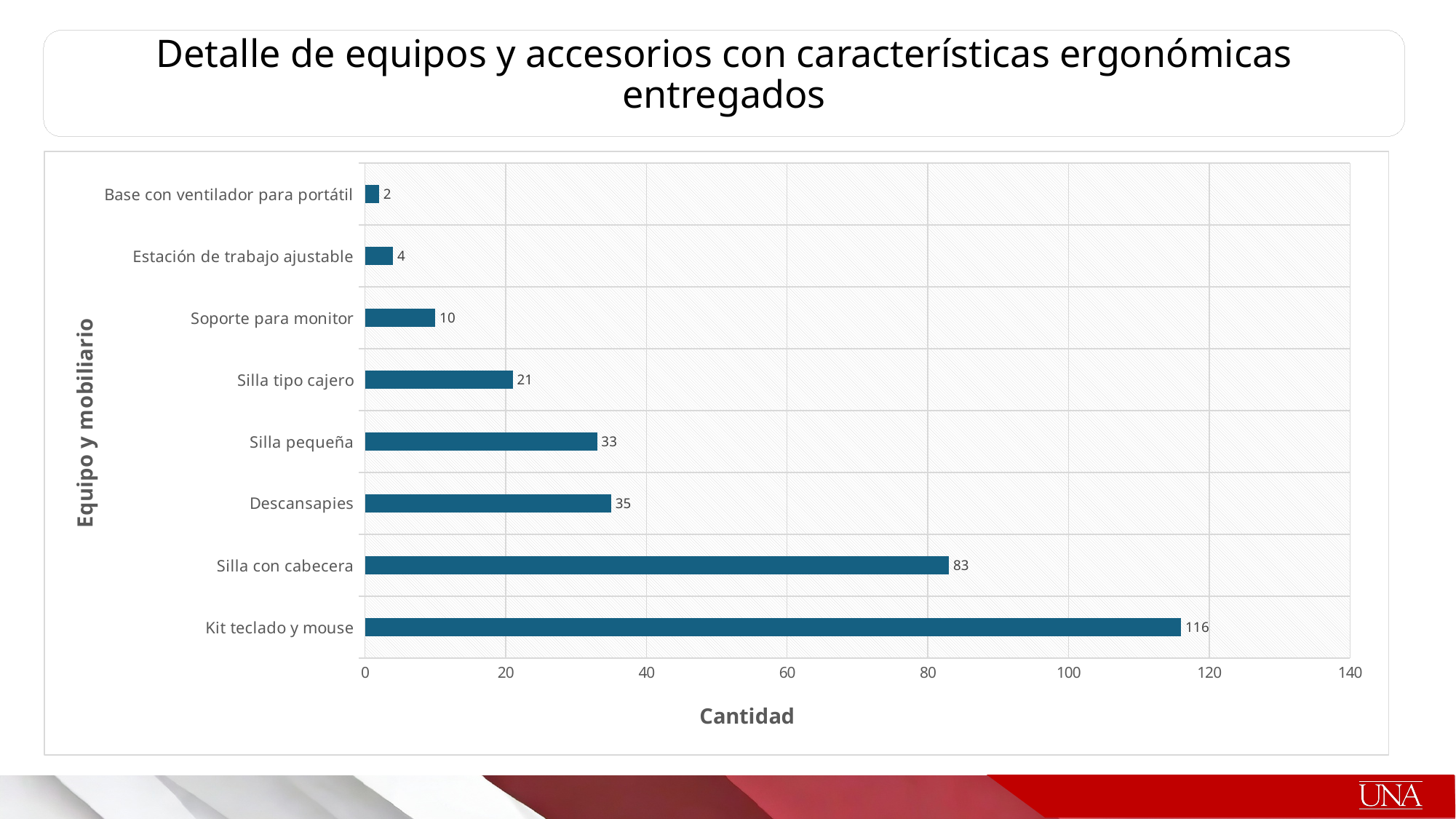
What is the value for Soporte para monitor? 10 Which category has the highest value? Kit teclado y mouse Which is larger, the value for Silla pequeña or the value for Silla tipo cajero? Silla pequeña What is the value for Base con ventilador para portátil? 2 What is the label of the horizontal axis? Cantidad What is the value for Kit teclado y mouse? 116 How many categories are shown in the chart? 8 Which category has the lowest value? Base con ventilador para portátil What is the value for Silla con cabecera? 83 What kind of chart is shown on the slide? bar chart Is the value for Silla con cabecera greater or less than 100? less What is the difference between the values for Kit teclado y mouse and Silla con cabecera? 33